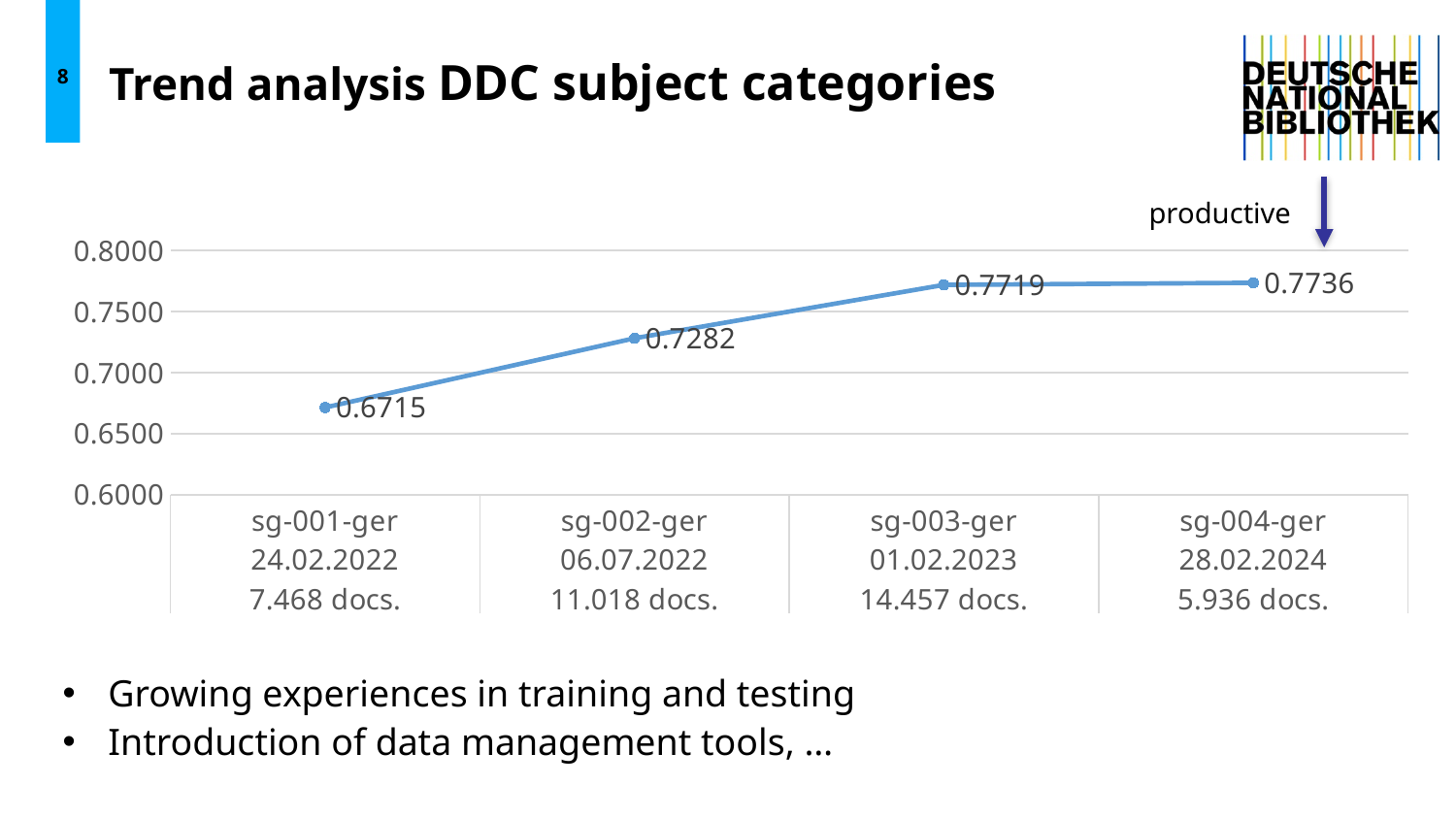
What is the value for sg-004-ger? 0.7736 Which category has the lowest value? sg-001-ger What is the value for sg-003-ger? 0.7719 Do the values rise or fall from sg-001-ger to sg-004-ger? rise What is the value for sg-001-ger? 0.6715 What is the difference between the values for sg-004-ger and sg-003-ger? 0.0017 What kind of chart is shown on the slide? line chart Which category has the highest value? sg-004-ger Which is larger, the value for sg-002-ger or sg-003-ger? sg-003-ger How many data points are plotted on the chart? 4 What is the difference between the values for sg-002-ger and sg-001-ger? 0.0567 What is the value for sg-002-ger? 0.7282